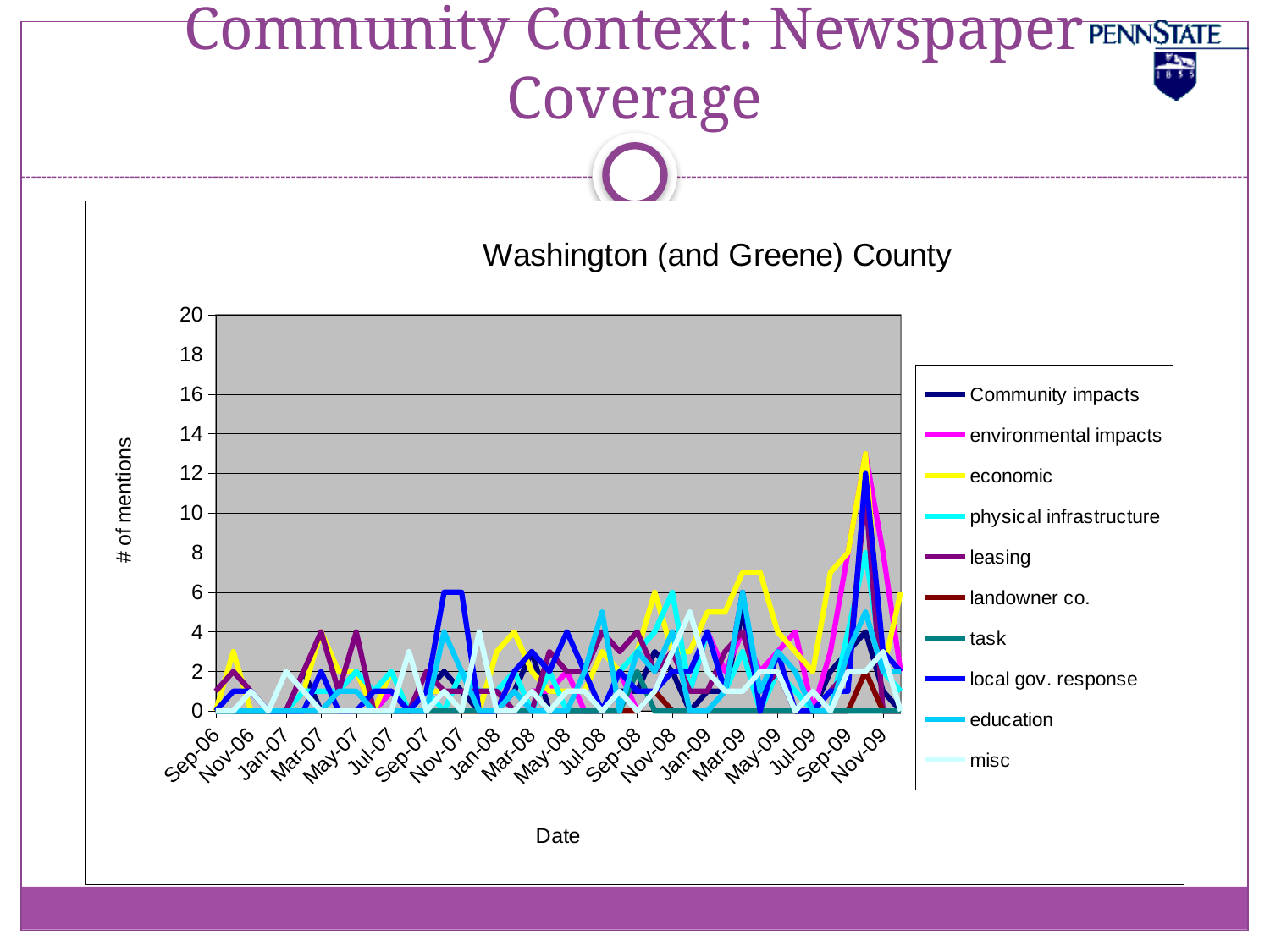
How many date labels are shown along the x axis? 20 What kind of chart is shown on the slide? line chart How many series does the legend list? 10 Is the highest value reached by any series on the chart greater or less than 14? less Does the number of mentions for the economic series generally rise or fall from Sep-06 to Nov-09? rise Is the value of the economic series at Sep-06 greater or less than 6? less What is the label on the vertical axis of the chart? # of mentions Is the peak of the local gov. response series in late 2007 greater or less than 4? greater What is the title of the chart? Washington (and Greene) County What is the maximum value shown on the vertical axis? 20